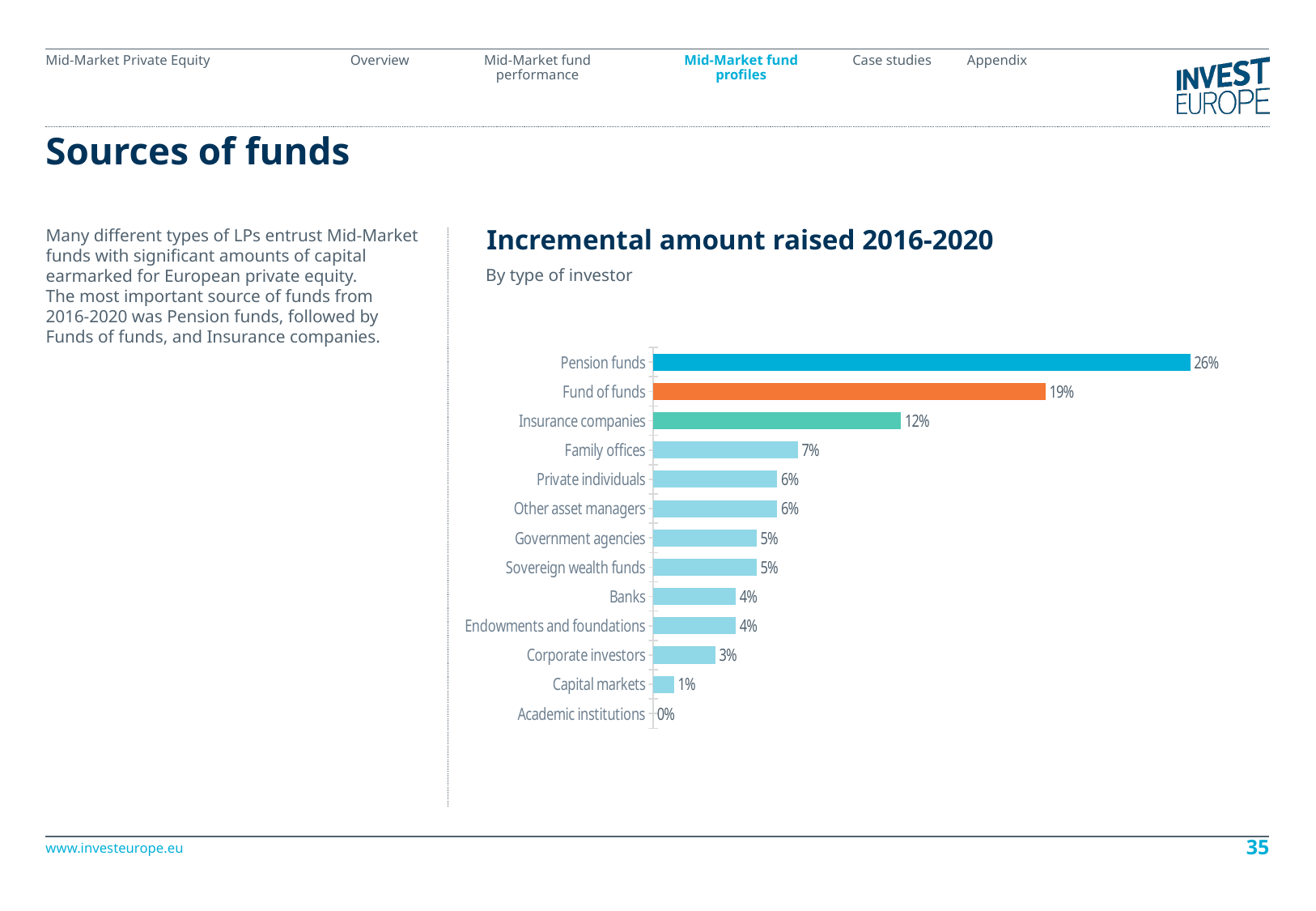
What is the value for Pension funds? 26% What is the value for Sovereign wealth funds? 5% Which is larger, the value for Fund of funds or the value for Insurance companies? Fund of funds What is the value for Capital markets? 1% What is the difference between the values for Pension funds and Fund of funds? 7% What is the value for Insurance companies? 12% How many types of investor are shown in the chart? 13 What is the difference between the values for Family offices and Corporate investors? 4% Which type of investor has the lowest value? Academic institutions What is the title of the chart? Incremental amount raised 2016-2020 Which type of investor has the highest value? Pension funds What kind of chart is shown on the slide? Bar chart